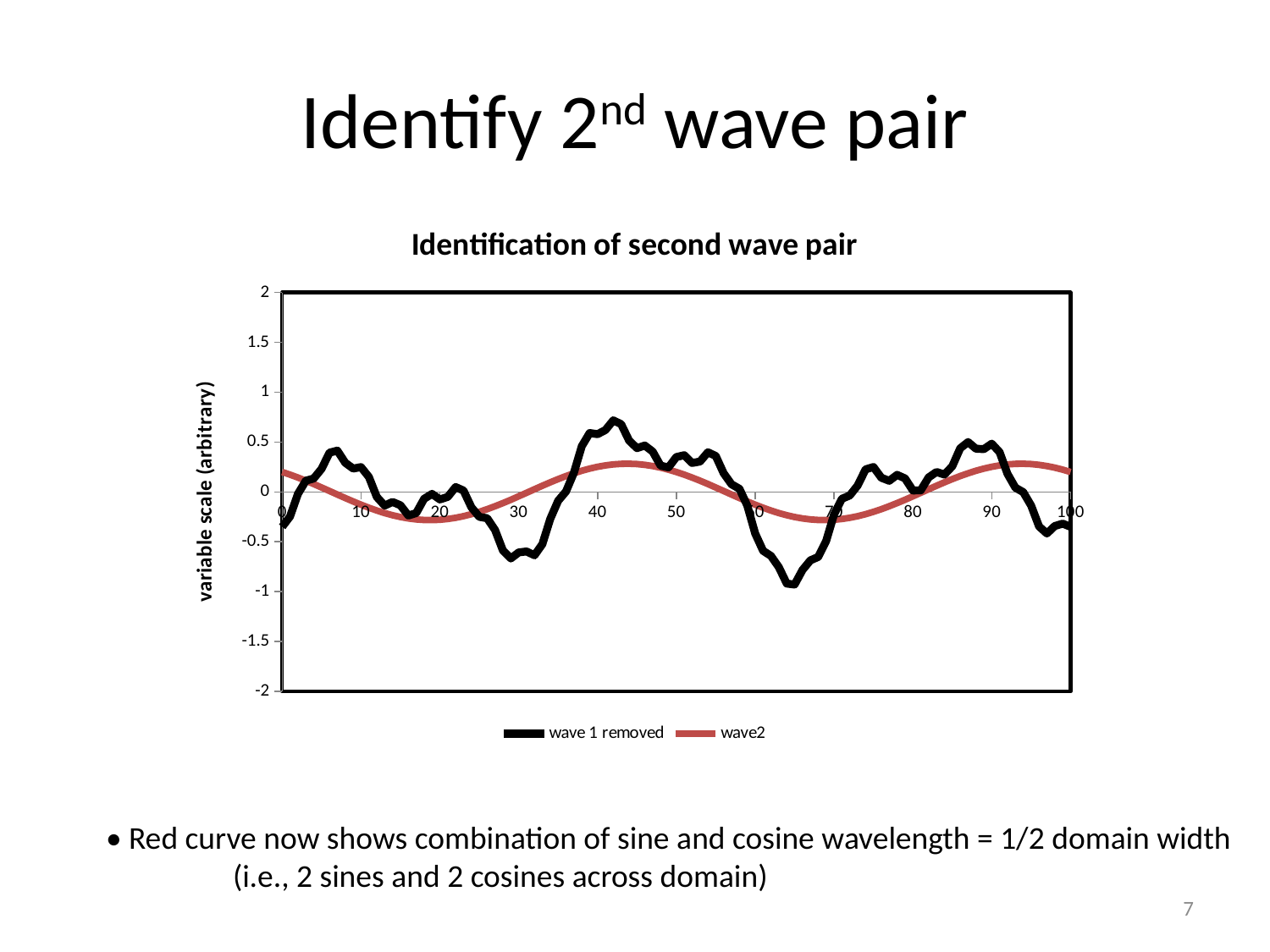
Which series reaches the higher maximum value, 'wave 1 removed' or 'wave2'? wave 1 removed What is the title of the chart? Identification of second wave pair What is the label on the vertical axis of the chart? variable scale (arbitrary) Is the value of the 'wave2' series at x = 45 greater or less than 0? greater What is the highest value shown on the vertical axis of the chart? 2 Is the value of the 'wave 1 removed' series at x = 42 greater or less than 0.5? greater Which series reaches the lower minimum value, 'wave 1 removed' or 'wave2'? wave 1 removed What kind of chart is shown on the slide? line chart Is the value of the 'wave2' series at x = 70 greater or less than 0? less How many series does the legend list? 2